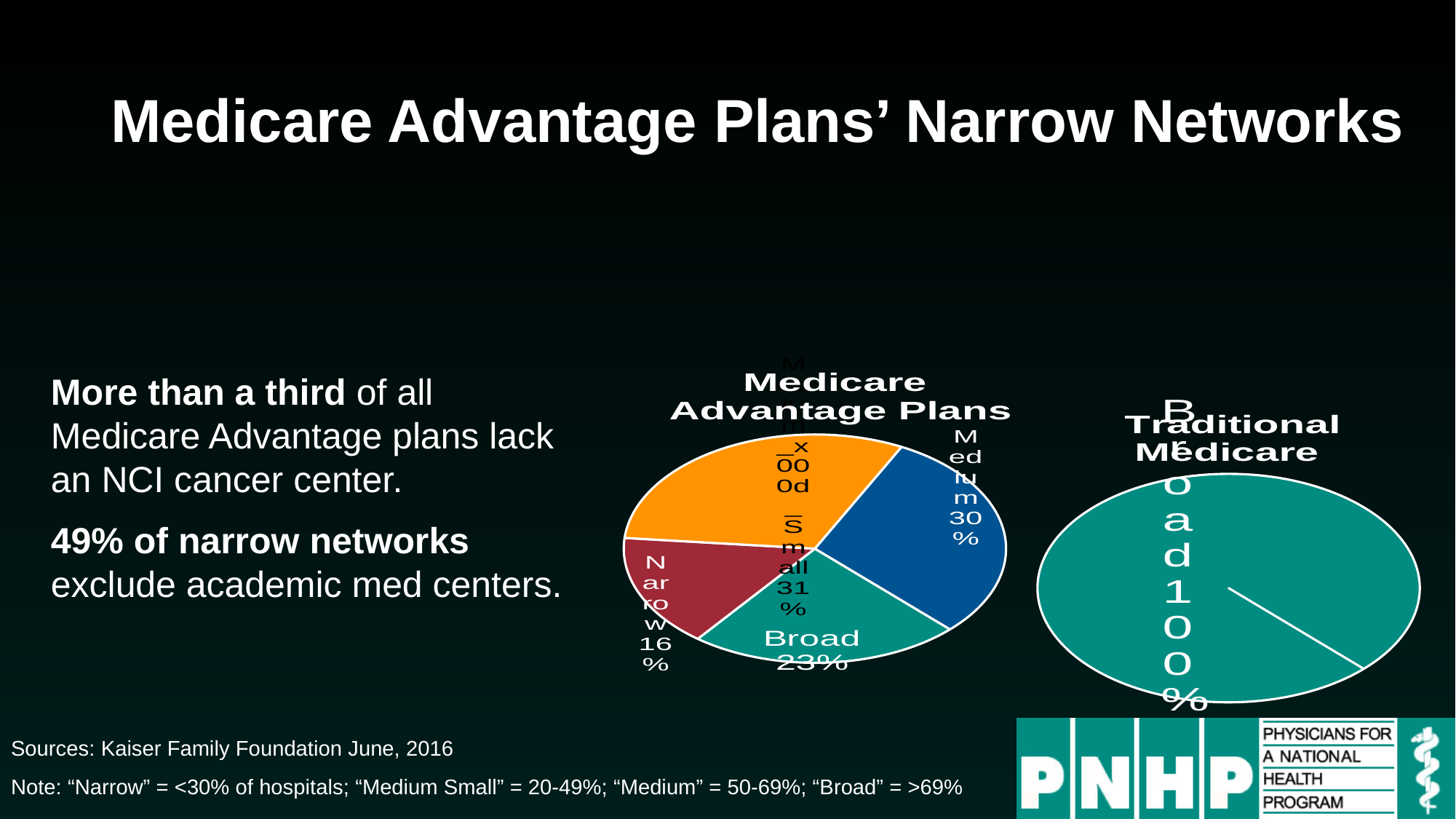
In the "Medicare Advantage Plans" chart, what share is labelled for Medium Small? 31% In the "Medicare Advantage Plans" chart, which is larger, Broad or Narrow? Broad What kind of chart is the "Medicare Advantage Plans" chart? pie chart What is the title of the pie chart on the right side of the slide? Traditional Medicare In the "Medicare Advantage Plans" chart, how many slices does the pie have? 4 In the "Medicare Advantage Plans" chart, which category has the smallest slice? Narrow In the "Medicare Advantage Plans" chart, what is the difference in percentage points between Broad and Narrow? 7 How many pie charts are shown on the slide? 2 In the "Traditional Medicare" chart, what share is labelled for Broad? 100% In the "Medicare Advantage Plans" chart, what share is labelled for Narrow? 16% In the "Medicare Advantage Plans" chart, what share is labelled for Broad? 23% In the "Medicare Advantage Plans" chart, what share is labelled for Medium? 30%